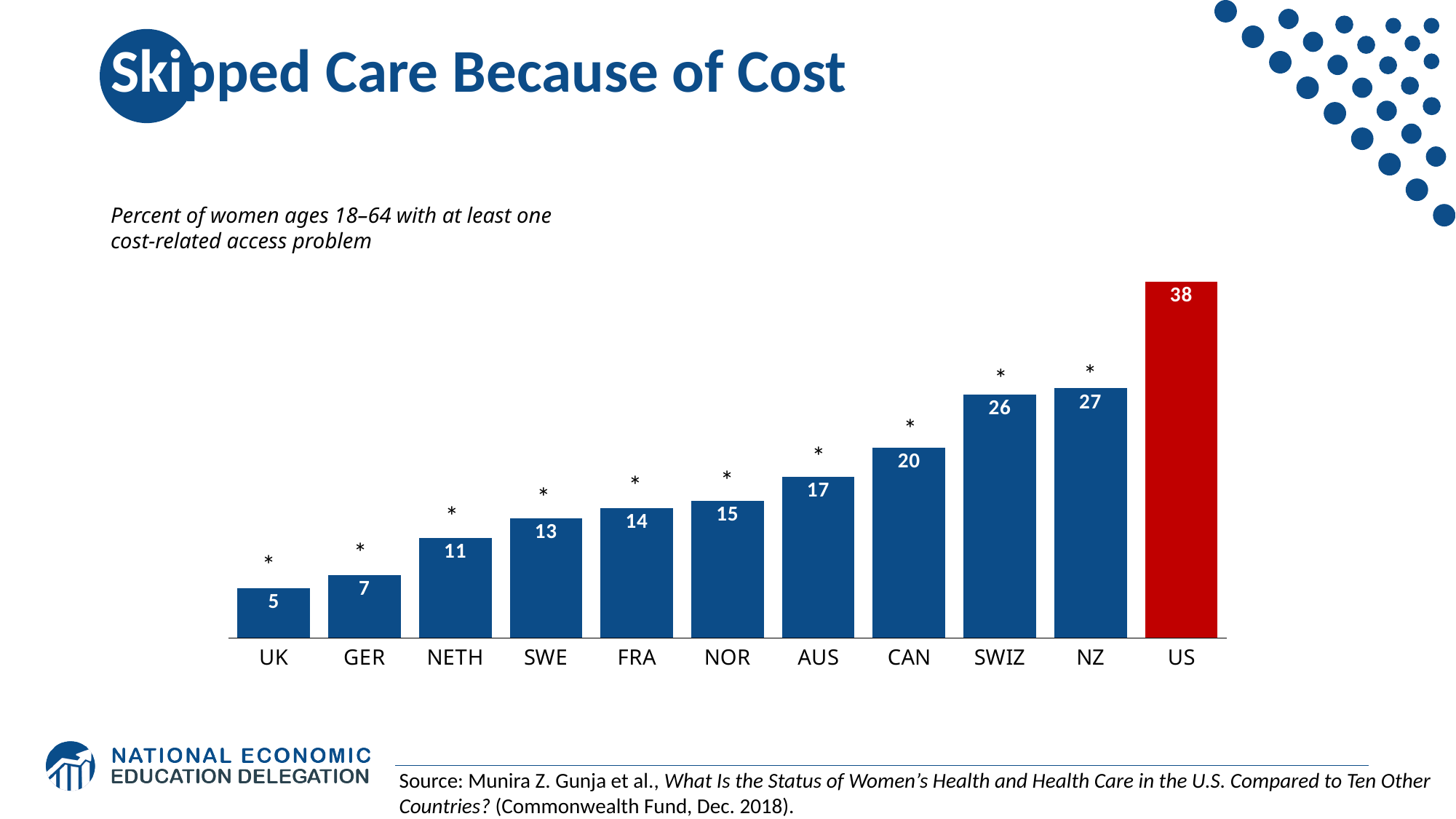
Which bar is coloured red rather than blue? US Which has a larger value, AUS or NOR? AUS What is the value for Germany (GER)? 7 What is the value for Canada (CAN)? 20 How many countries are shown in the chart? 11 Which country has the lowest value? UK What is the difference between the values for the US and NZ? 11 What is the value for the US? 38 Do the values rise or fall from left to right across the countries? Rise What is the difference between the values for SWE and UK? 8 Which country has the highest value? US What kind of chart is shown on the slide? Bar chart